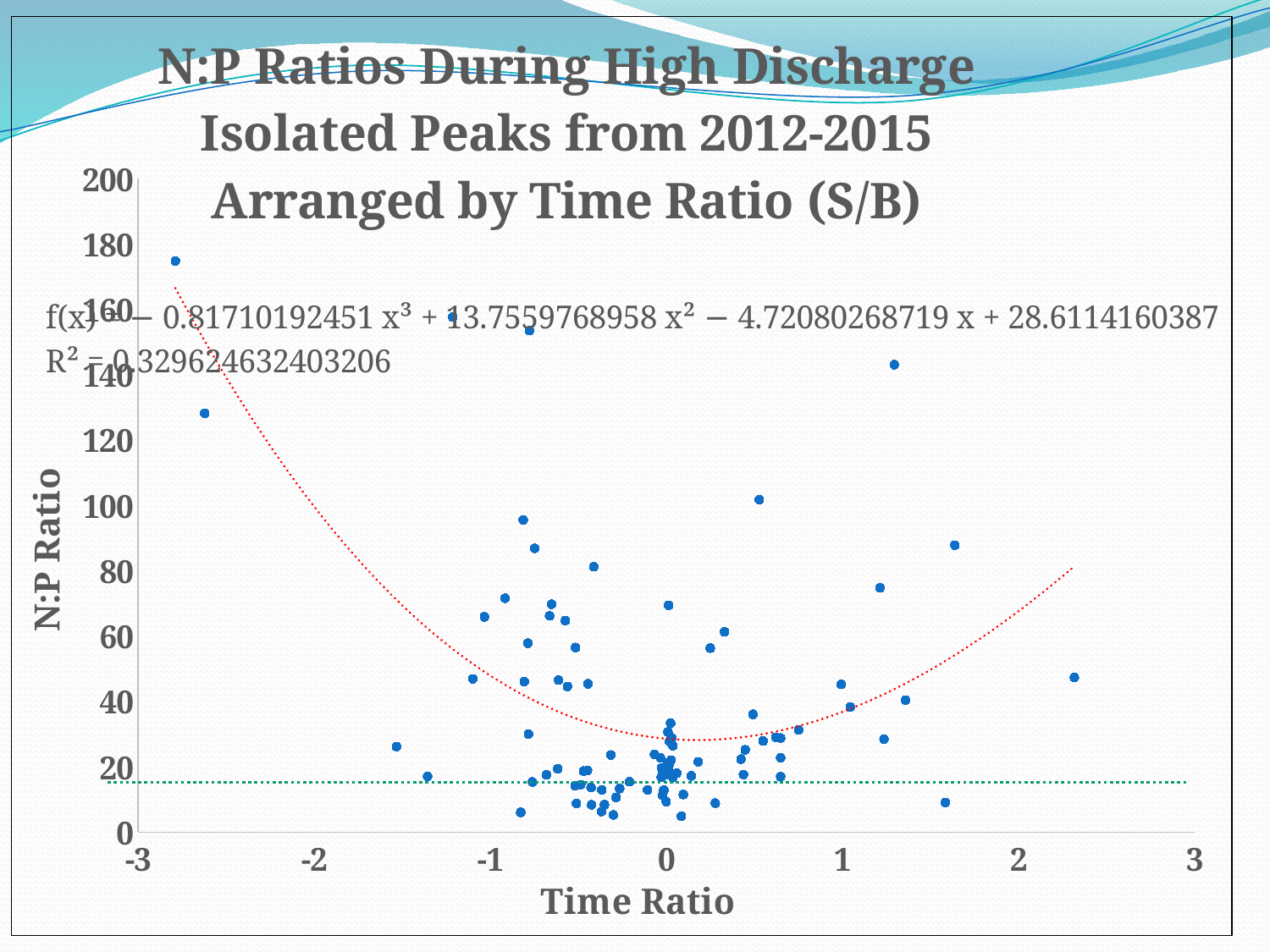
Is the N:P Ratio of the point near Time Ratio -2.6 greater or less than 120? greater Is the N:P Ratio of the rightmost point (near Time Ratio 2.3) greater or less than 40? greater What kind of chart is shown on the slide? scatter plot What is the coefficient of x³ in the trendline equation? −0.81710192451 What is the title of the x axis? Time Ratio What is the title of the y axis? N:P Ratio What is the constant term in the trendline equation f(x)? 28.6114160387 What R² value is printed for the trendline? 0.329624632403206 Is the horizontal green dotted line at an N:P Ratio greater or less than 20? less Is the point with the highest N:P Ratio located at a negative or a positive Time Ratio? negative What is the coefficient of x² in the trendline equation? 13.7559768958